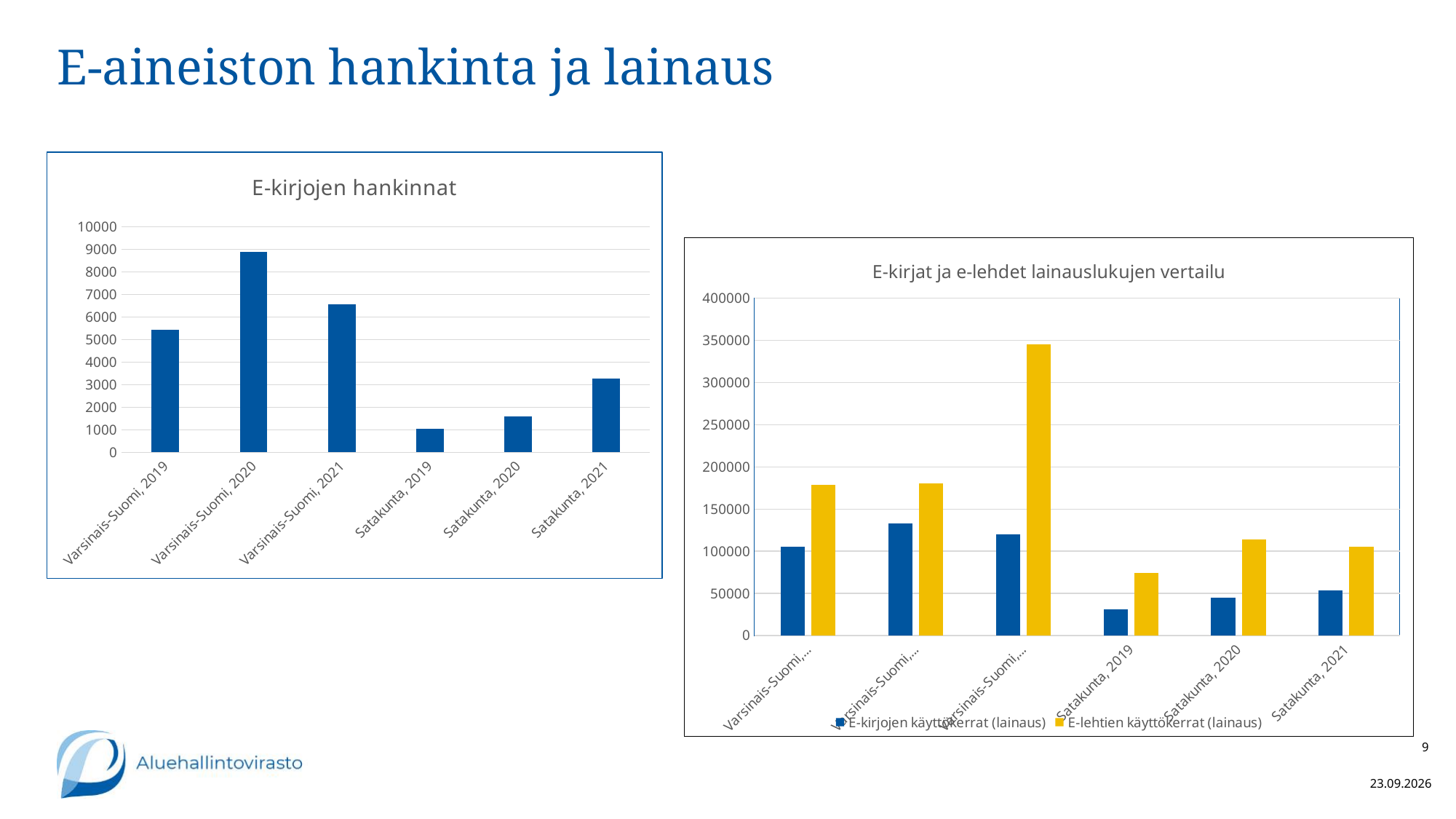
In the 'E-kirjojen hankinnat' chart, is the value for Varsinais-Suomi, 2020 greater or less than 8000? greater In the 'E-kirjat ja e-lehdet lainauslukujen vertailu' chart, is the value of E-lehtien käyttökerrat (lainaus) for Satakunta, 2020 greater or less than 100000? greater How many series does the legend of the 'E-kirjat ja e-lehdet lainauslukujen vertailu' chart list? 2 In the 'E-kirjat ja e-lehdet lainauslukujen vertailu' chart, is the value of E-kirjojen käyttökerrat (lainaus) for Satakunta, 2019 greater or less than 50000? less What is the title of the chart on the right side of the slide? E-kirjat ja e-lehdet lainauslukujen vertailu In the 'E-kirjojen hankinnat' chart, which is larger: Varsinais-Suomi, 2021 or Satakunta, 2021? Varsinais-Suomi, 2021 What kind of chart is the 'E-kirjojen hankinnat' chart? bar chart In the 'E-kirjojen hankinnat' chart, which category has the highest value? Varsinais-Suomi, 2020 In the 'E-kirjat ja e-lehdet lainauslukujen vertailu' chart, for Satakunta, 2021, which series has the larger value? E-lehtien käyttökerrat (lainaus) In the 'E-kirjojen hankinnat' chart, which category has the lowest value? Satakunta, 2019 How many categories are shown in the 'E-kirjojen hankinnat' chart? 6